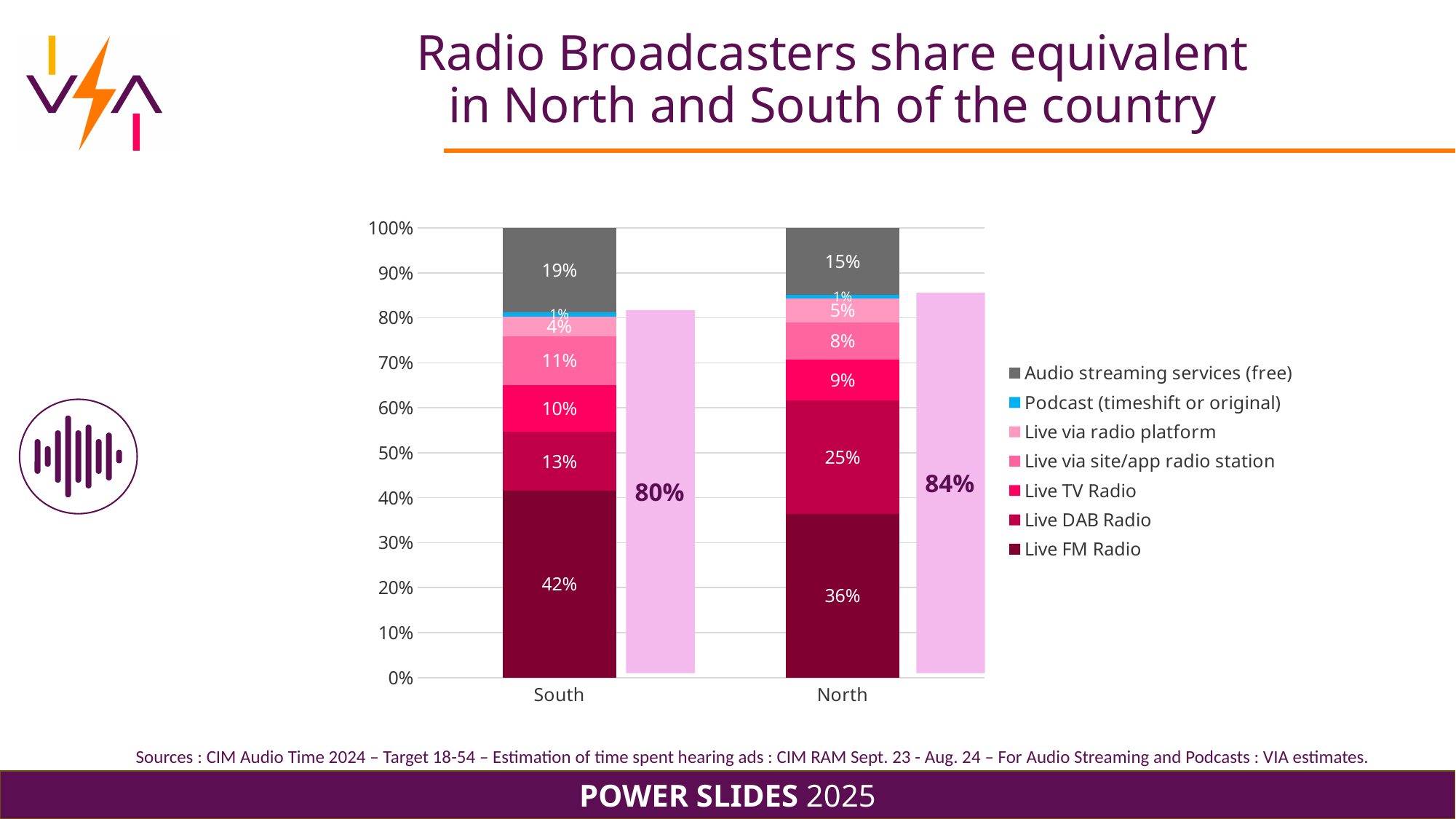
How many regions are shown on the x axis? 2 How many series does the legend list? 7 What is the value for Live FM Radio in the South bar? 42% Which series has the largest segment in the North stacked bar? Live FM Radio What is the value for Live DAB Radio in the North bar? 25% What is the value for Live via site/app radio station in the South bar? 11% What is the value for Audio streaming services (free) in the South bar? 19% Which region has the larger Live FM Radio value, South or North? South What is the difference between the Live DAB Radio values for North and South? 12 percentage points What kind of chart is shown on the slide? Stacked bar chart Which series has the smallest segment in the South stacked bar? Podcast (timeshift or original) What radio broadcasters share equivalent is shown by the light pink bar for North? 84%